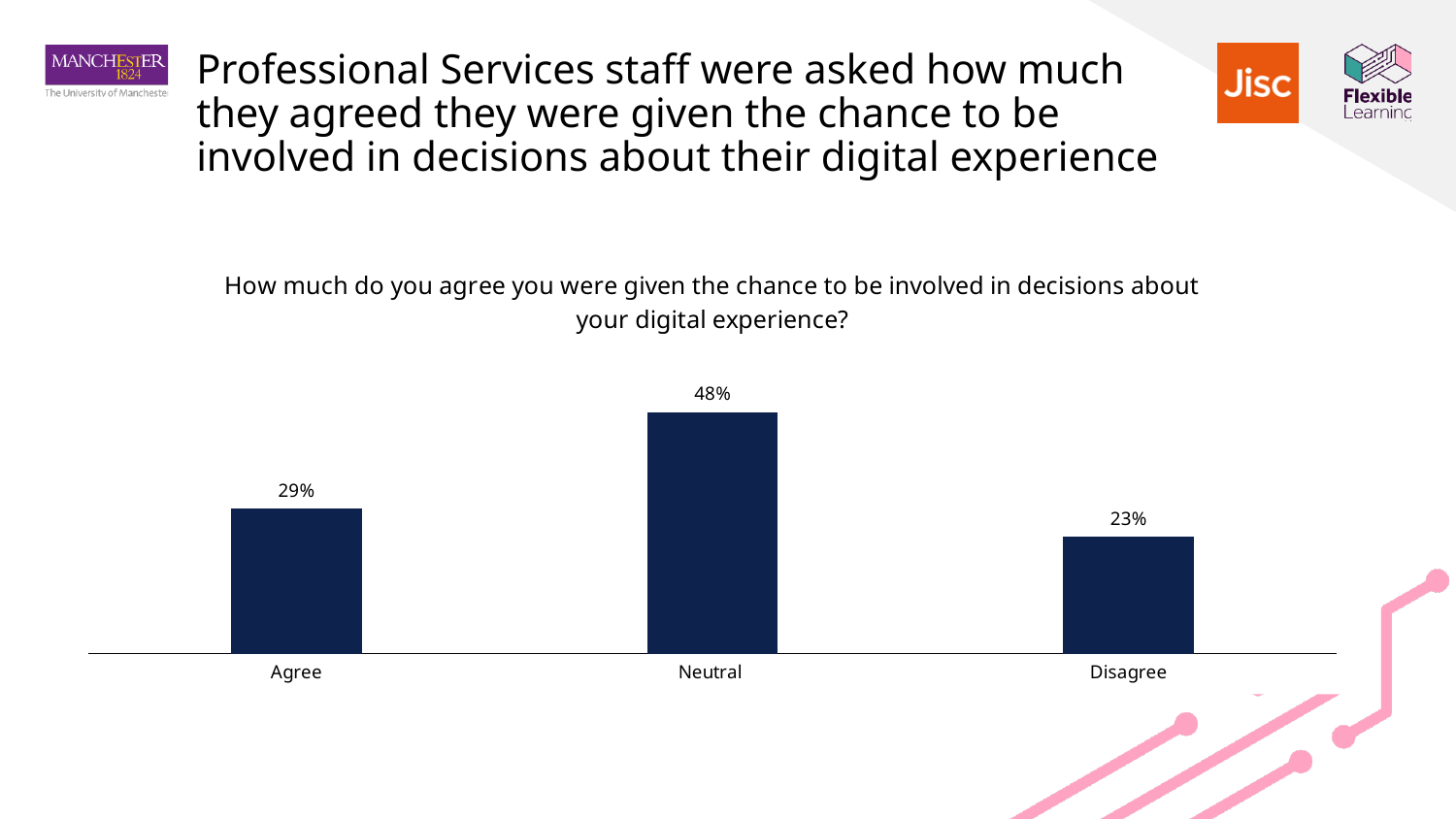
What kind of chart is shown on the slide? Bar chart What is the difference in percentage points between Neutral and Agree? 19 How many response categories are shown on the chart? 3 Which response category has the lowest percentage? Disagree What percentage of respondents answered Agree? 29% What is the total of the three percentages shown on the chart? 100% What percentage of respondents answered Disagree? 23% What is the title of the chart? How much do you agree you were given the chance to be involved in decisions about your digital experience? Which is larger, the percentage for Agree or the percentage for Disagree? Agree Which response category has the highest percentage? Neutral What is the difference in percentage points between Agree and Disagree? 6 What percentage of respondents answered Neutral? 48%